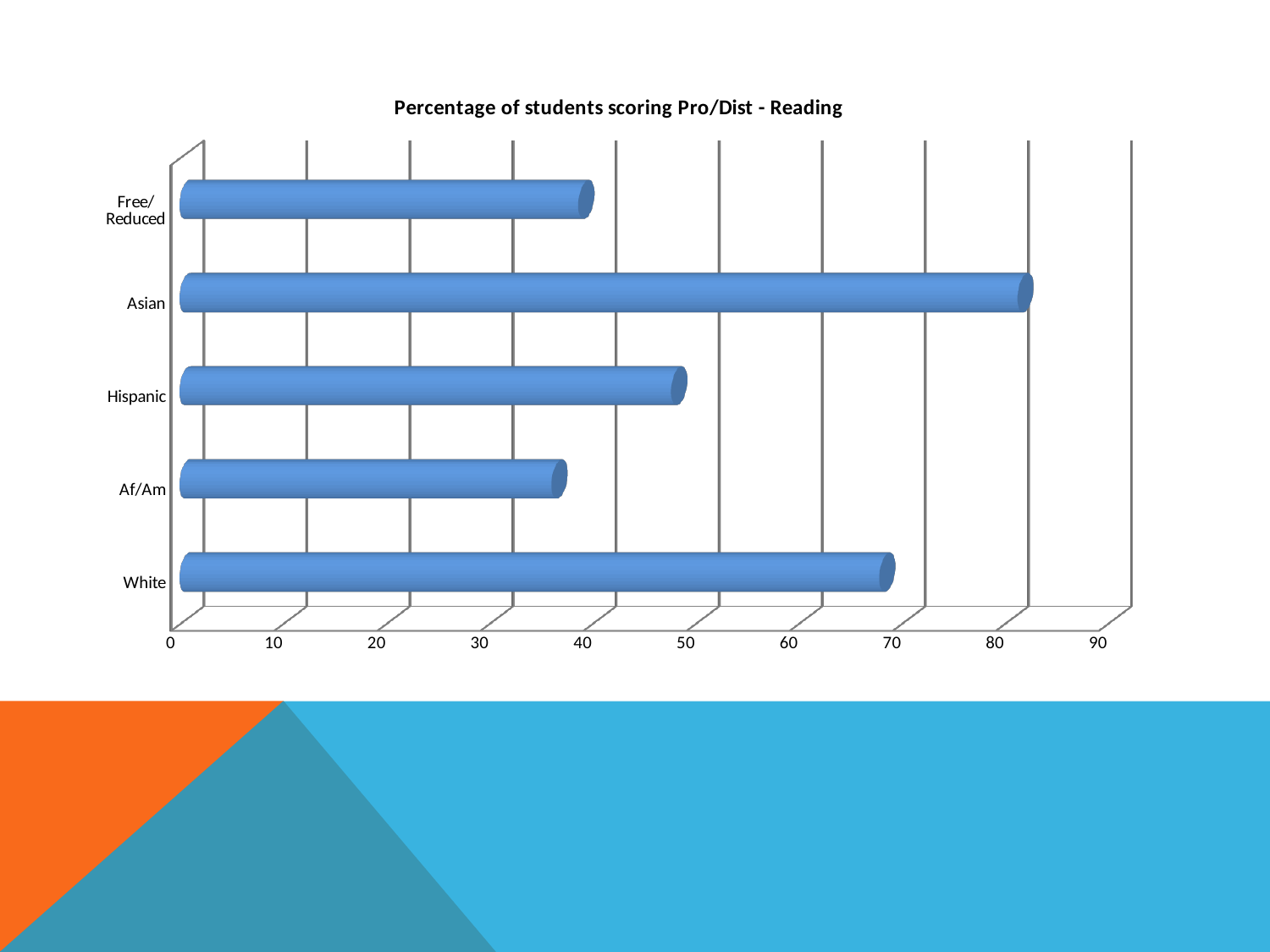
Is the value for Asian greater or less than 70? greater Is the value for Af/Am greater or less than 40? less Which category has the lowest percentage of students scoring Pro/Dist in Reading? Af/Am Which is larger, the value for White or the value for Hispanic? White Is the value for White greater or less than 60? greater What is the title of the chart? Percentage of students scoring Pro/Dist - Reading What kind of chart is shown on the slide? bar chart Which category has the highest percentage of students scoring Pro/Dist in Reading? Asian How many categories are plotted in the chart? 5 Which is larger, the value for Asian or the value for White? Asian